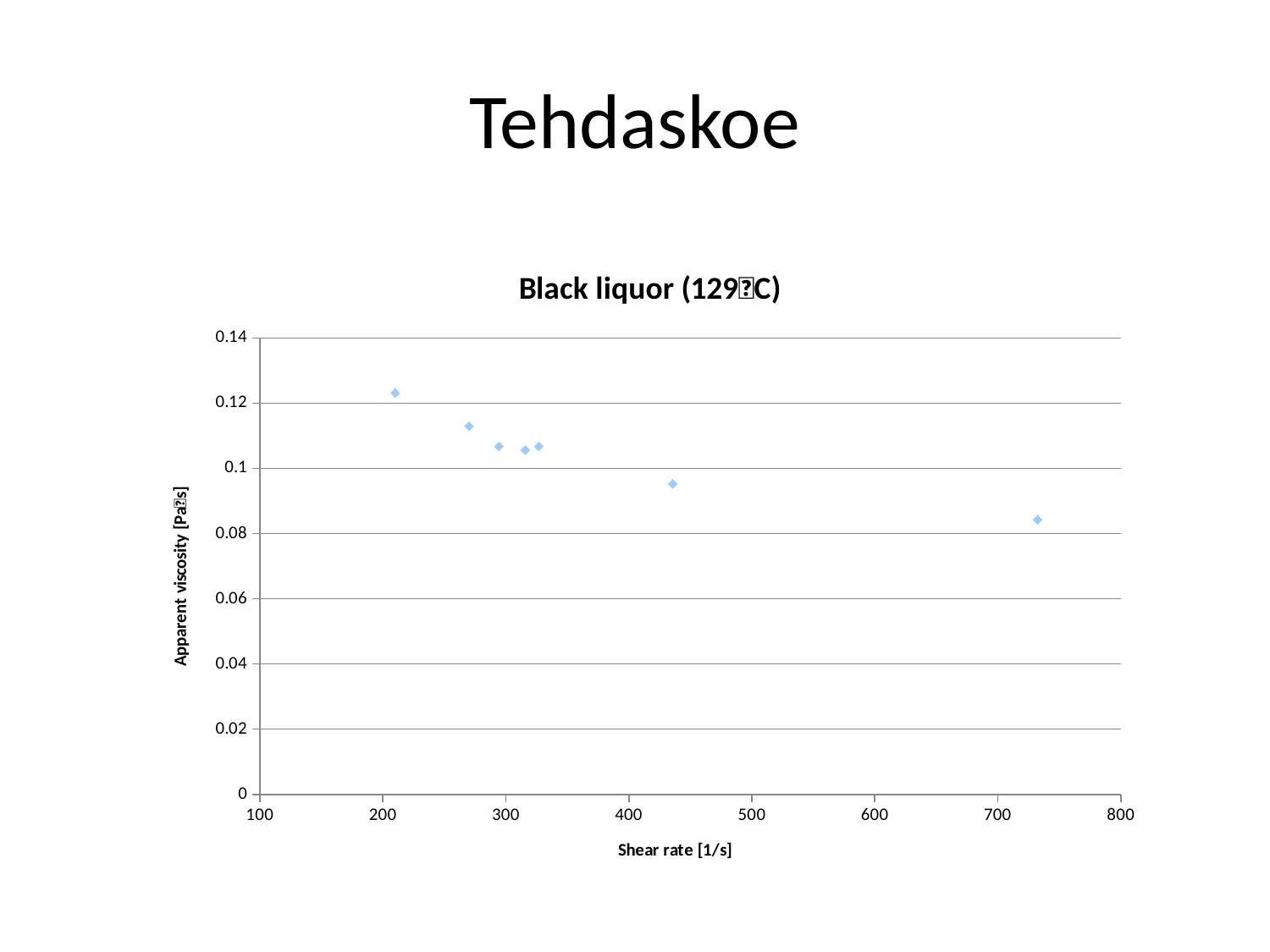
Are any data points plotted above 0.14 on the y axis? No Is the apparent viscosity at the highest shear rate greater or less than 0.08? greater Which has the higher apparent viscosity: the point at the lowest shear rate or the point at the highest shear rate? the point at the lowest shear rate Is the apparent viscosity at a shear rate of about 435 1/s greater or less than 0.1? less How many data points are plotted in the chart? 7 What kind of chart is shown on the slide? scatter chart What is the label of the x axis? Shear rate [1/s] How many data points have an apparent viscosity above 0.1? 5 Does the apparent viscosity rise or fall as the shear rate increases along the x axis? fall What substance is named in the chart title? Black liquor